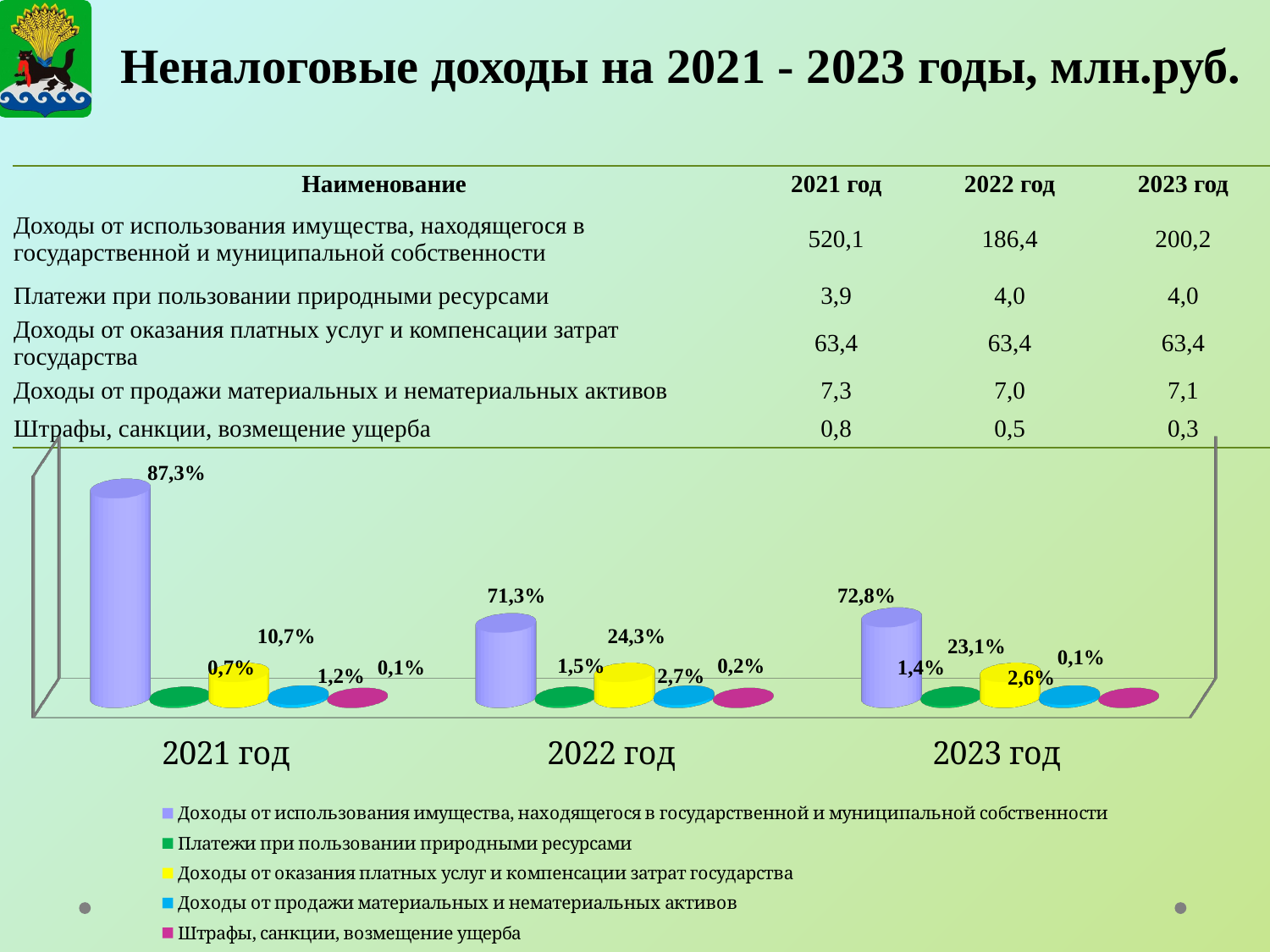
Which is larger on the chart: the share of 'Платежи при пользовании природными ресурсами' in 2022 год or in 2023 год? 2022 год What is the share of 'Штрафы, санкции, возмещение ущерба' in 2022 год according to the chart? 0,2% What is the share of 'Доходы от оказания платных услуг и компенсации затрат государства' in 2022 год according to the chart? 24,3% By how many percentage points does the share of 'Доходы от использования имущества, находящегося в государственной и муниципальной собственности' in 2021 год exceed its share in 2022 год on the chart? 16,0% How many year groups are shown on the x axis of the chart? 3 Does the share of 'Доходы от использования имущества, находящегося в государственной и муниципальной собственности' rise or fall from 2021 год to 2022 год on the chart? fall How many series does the chart legend list? 5 Which series has the lowest share in 2021 год on the chart? Штрафы, санкции, возмещение ущерба Which series has the highest share in 2023 год on the chart? Доходы от использования имущества, находящегося в государственной и муниципальной собственности What is the share of 'Доходы от продажи материальных и нематериальных активов' in 2023 год according to the chart? 2,6% What is the share of 'Доходы от использования имущества, находящегося в государственной и муниципальной собственности' in 2021 год according to the chart? 87,3% What kind of chart is shown on the slide? bar chart